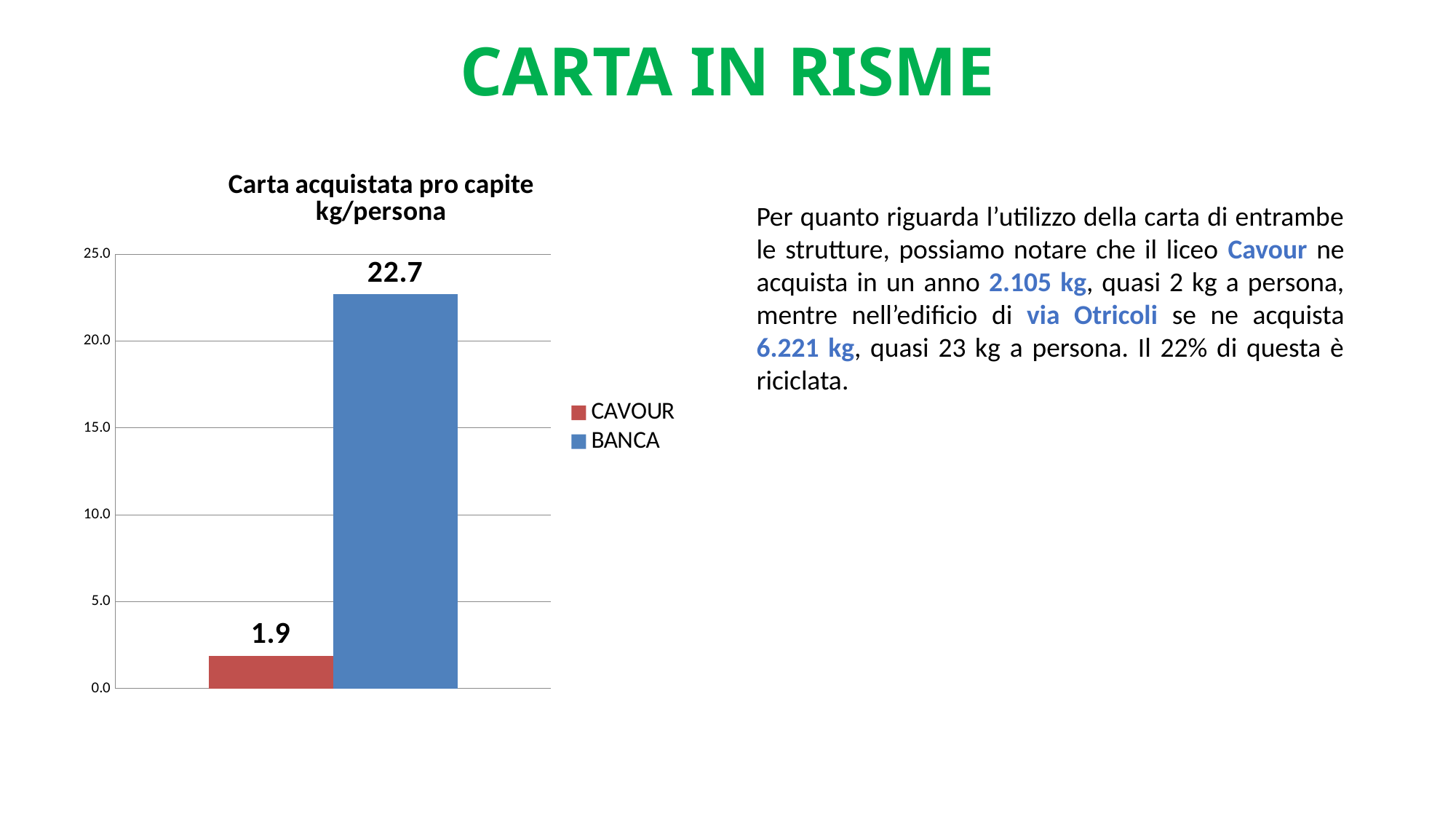
What kind of chart is shown on the slide? bar chart What is the value for CAVOUR in the chart? 1.9 Is the value for CAVOUR greater or less than 5.0? less What is the value for BANCA in the chart? 22.7 Is the value for BANCA greater or less than 20.0? greater What is the title of the chart? Carta acquistata pro capite kg/persona What colour is the BANCA bar in the chart? blue Which series has the lowest value in the chart? CAVOUR What is the difference between the BANCA value and the CAVOUR value? 20.8 Which series has the highest value in the chart? BANCA How many series does the legend list? 2 Which is larger, the value for CAVOUR or the value for BANCA? BANCA